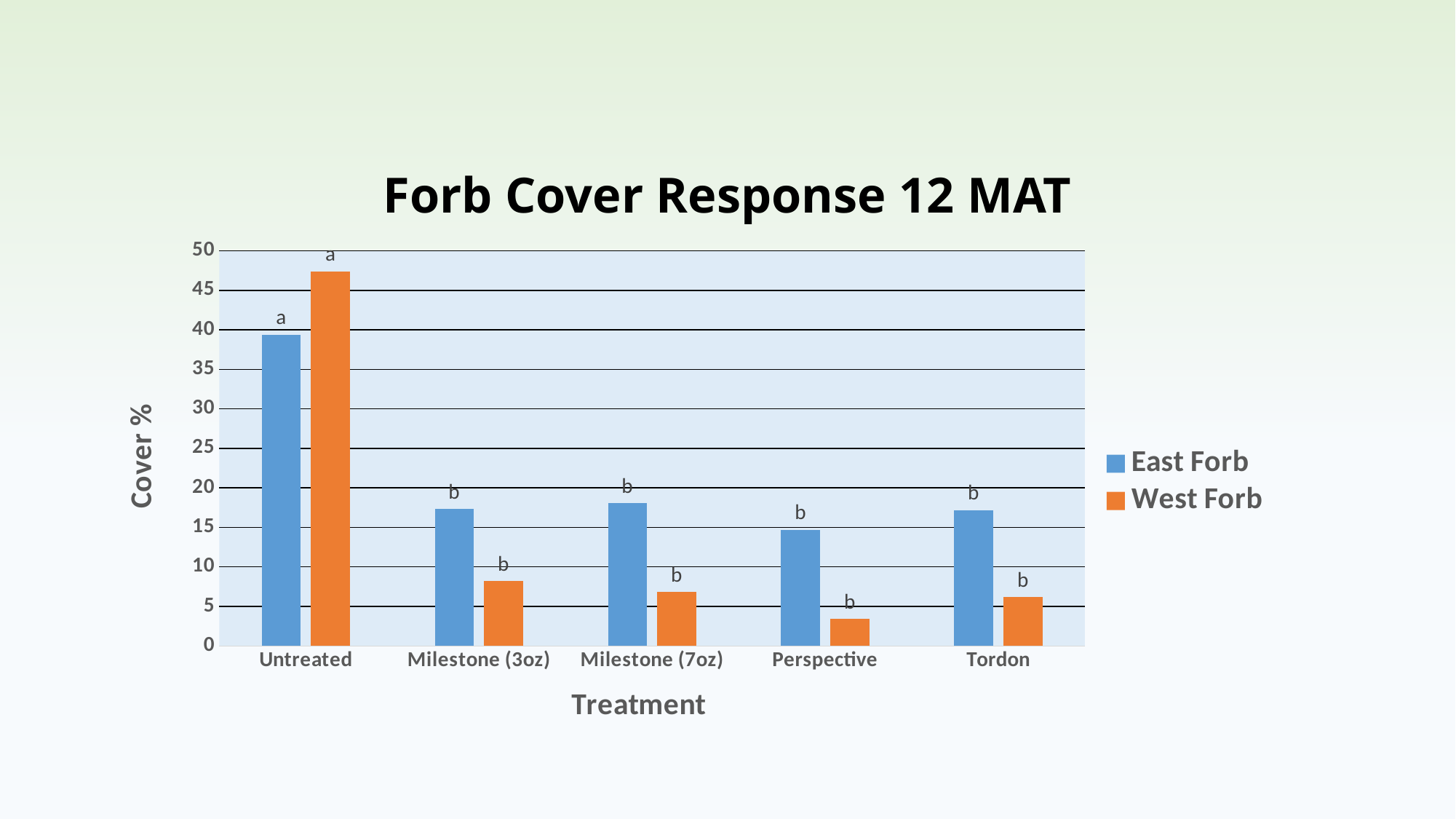
Is the West Forb value for Milestone (3oz) greater or less than 10? less Is the West Forb value for Untreated greater or less than 45? greater For Milestone (7oz), which is larger: East Forb or West Forb? East Forb How many treatment categories are shown on the x axis? 5 What kind of chart is shown on the slide? bar chart Which treatment has the lowest West Forb cover? Perspective For the Untreated treatment, which is larger: East Forb or West Forb? West Forb Which treatment has the highest East Forb cover? Untreated Is the East Forb value for Perspective greater or less than 10? greater Which treatment has the lowest East Forb cover? Perspective What is the title of the chart? Forb Cover Response 12 MAT How many series does the legend list? 2